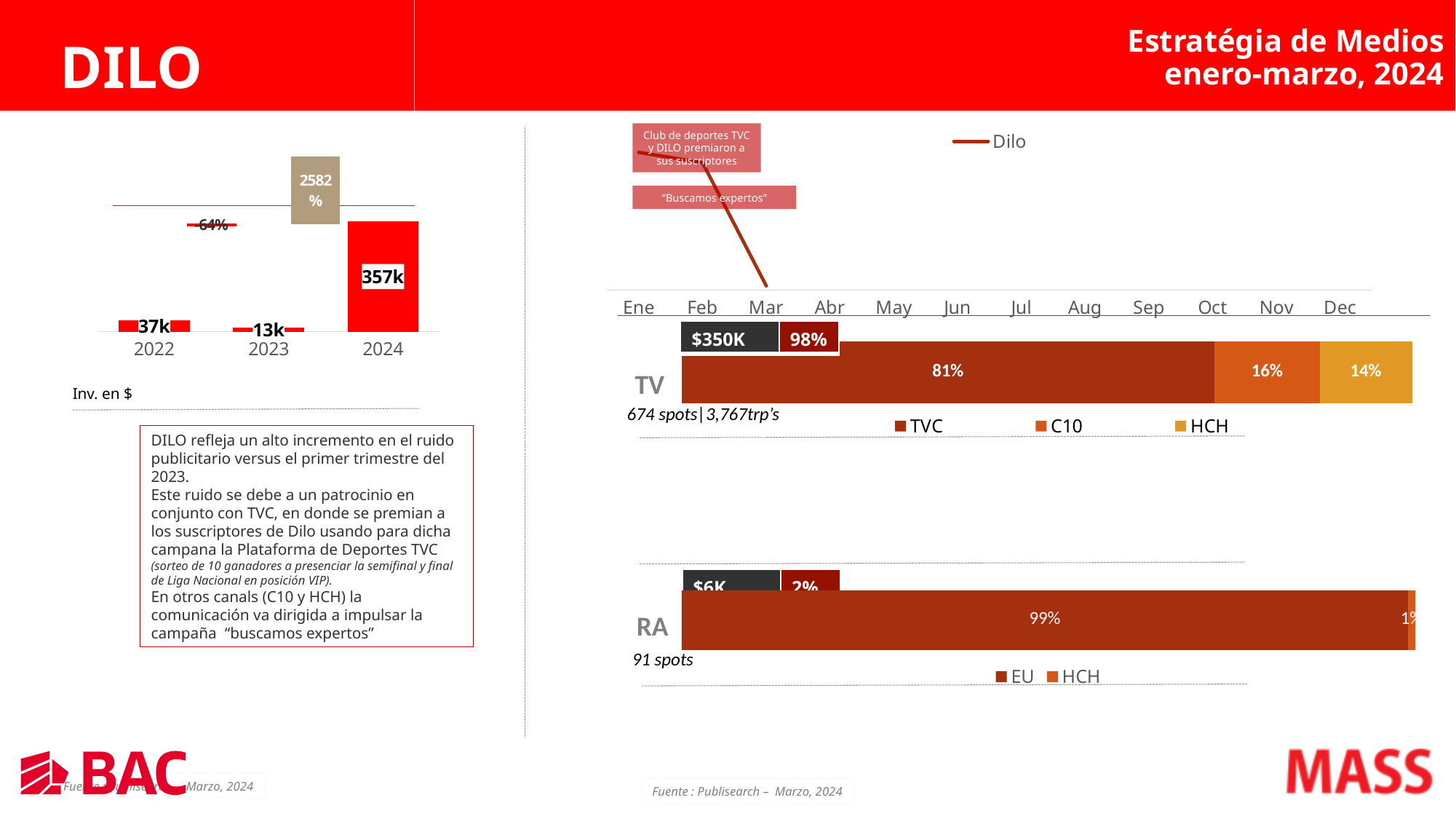
In the TV stacked bar chart on the right, what share is shown for TVC? 81% In the investment bar chart on the left (Inv. en $), what is the value for 2023? 13k In the investment bar chart on the left (Inv. en $), what is the value for 2022? 37k In the investment bar chart on the left (Inv. en $), what is the value for 2024? 357k In the RA stacked bar chart on the right, what share is shown for EU? 99% In the RA stacked bar chart on the right, which series has the larger share, EU or HCH? EU In the TV stacked bar chart on the right, what share is shown for C10? 16% In the investment bar chart on the left (Inv. en $), which year has the highest value? 2024 In the investment bar chart on the left (Inv. en $), which year has the lowest value? 2023 In the TV stacked bar chart on the right, how many series does the legend list? 3 In the investment bar chart on the left (Inv. en $), what percentage change is shown for 2024? 2582% In the investment bar chart on the left (Inv. en $), how many years are shown? 3